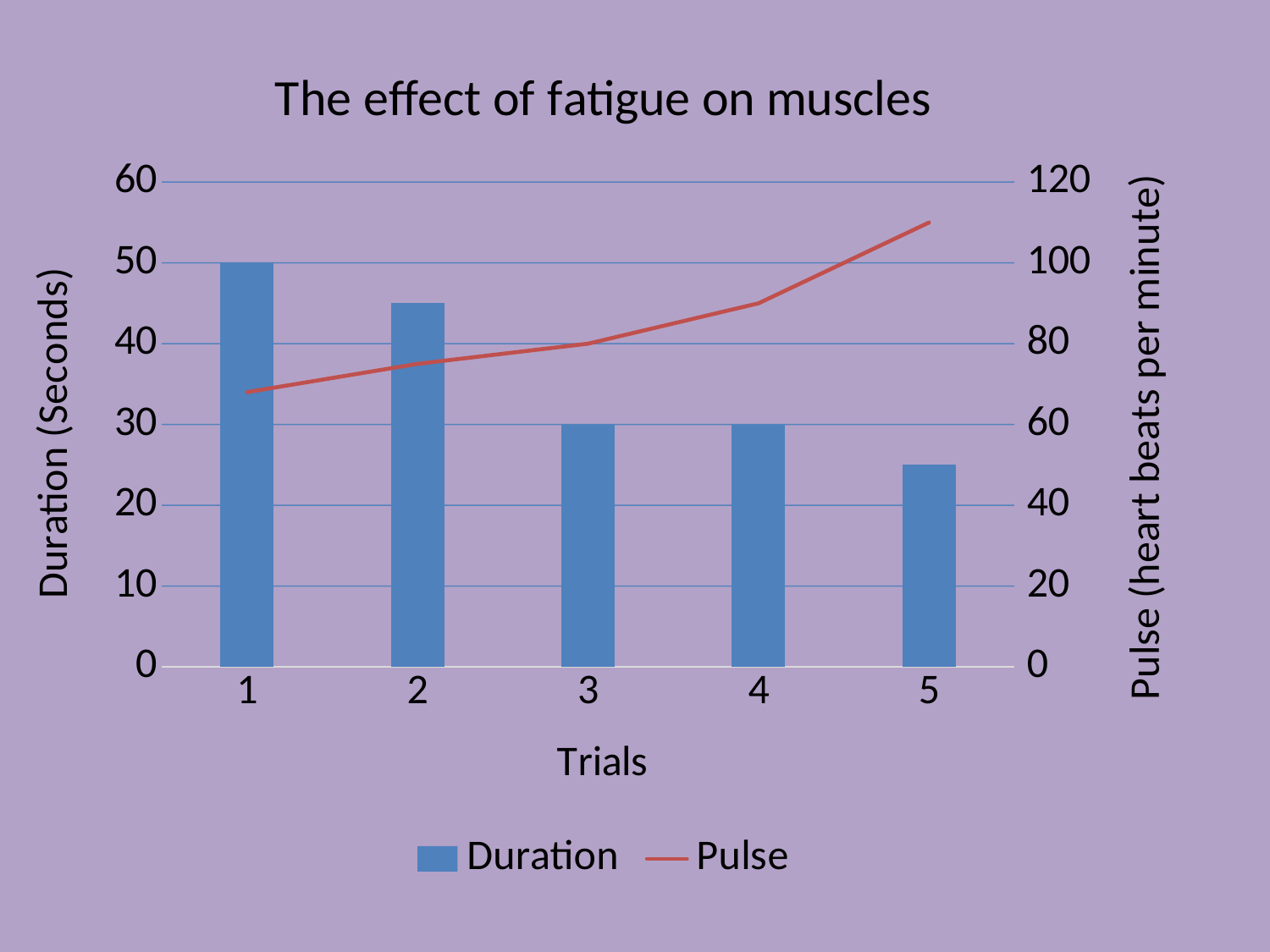
How many trials are plotted on the x axis? 5 How many series does the legend list? 2 Which trial has the lowest Duration? Trial 5 What is the title of the chart? The effect of fatigue on muscles Is the Pulse value for trial 5 greater or less than 100? greater What is the Duration value for trial 3? 30 Does the Pulse line rise or fall from trial 1 to trial 5? rise What is the difference between the Duration values for trial 1 and trial 3? 20 Which trial has the highest Duration? Trial 1 What kind of chart is shown on the slide? A combined bar and line chart Is the Duration value for trial 2 greater or less than 40? greater What is the Duration value for trial 1? 50